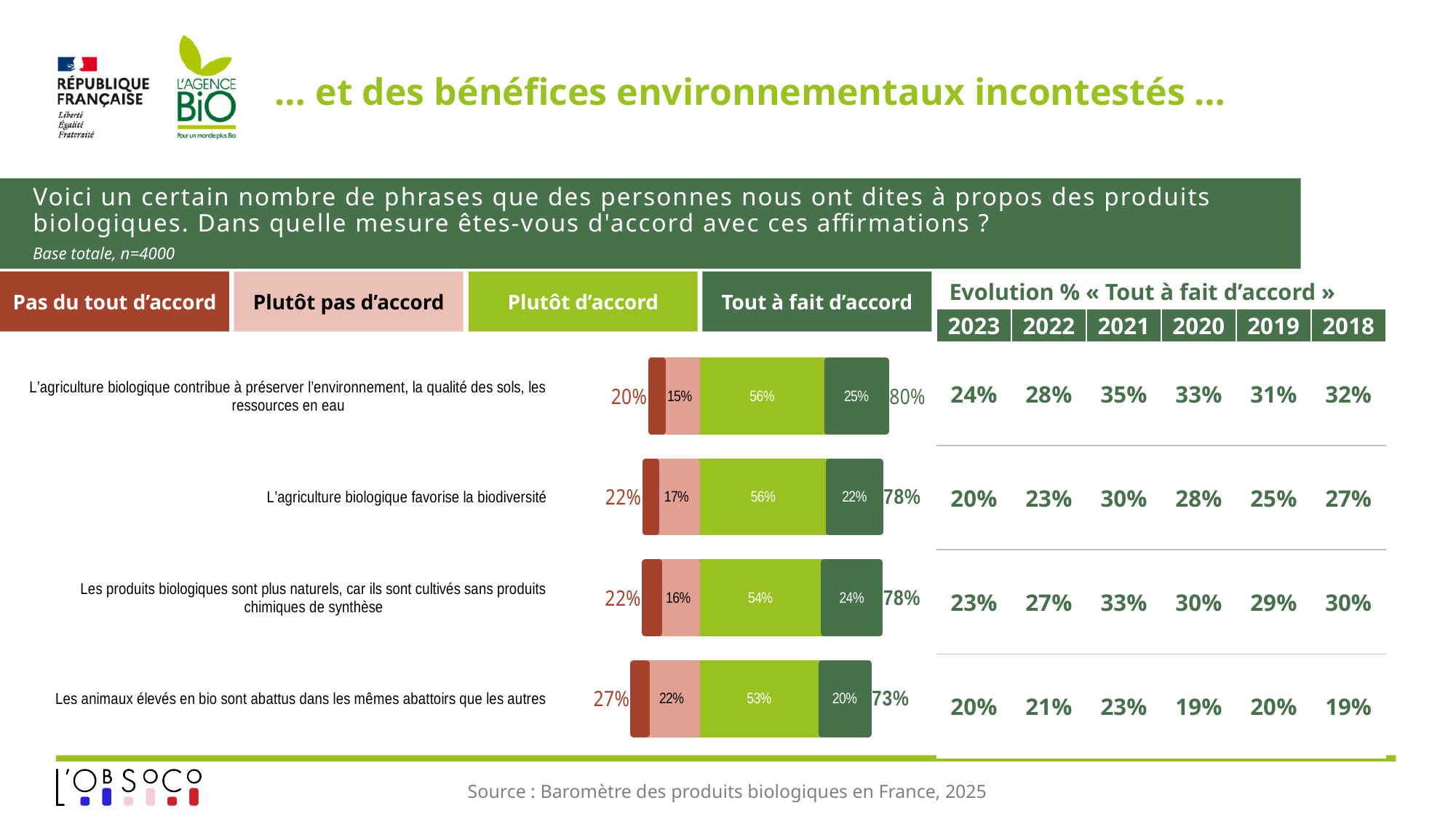
Which statement has the highest combined agreement total (Plutôt d'accord + Tout à fait d'accord)? L'agriculture biologique contribue à préserver l'environnement, la qualité des sols, les ressources en eau What is the 'Plutôt d'accord' value for the statement 'Les produits biologiques sont plus naturels, car ils sont cultivés sans produits chimiques de synthèse'? 54% What is the difference between the 'Tout à fait d'accord' values for 'L'agriculture biologique contribue à préserver l'environnement...' and 'Les animaux élevés en bio sont abattus dans les mêmes abattoirs que les autres'? 5% How many response categories does the legend list for the bar chart? 4 What is the 'Tout à fait d'accord' value for the statement 'L'agriculture biologique contribue à préserver l'environnement, la qualité des sols, les ressources en eau'? 25% In the 'Evolution % « Tout à fait d'accord »' table, what was the 2021 value for 'L'agriculture biologique favorise la biodiversité'? 30% What kind of chart is used to show the levels of agreement with the statements? Stacked bar chart What is the 'Plutôt pas d'accord' value for the statement 'Les animaux élevés en bio sont abattus dans les mêmes abattoirs que les autres'? 22% Which statement has the lowest 'Tout à fait d'accord' value? Les animaux élevés en bio sont abattus dans les mêmes abattoirs que les autres What is the combined disagreement total shown for the statement 'Les animaux élevés en bio sont abattus dans les mêmes abattoirs que les autres'? 27% How many statements are plotted in the bar chart? 4 Which is larger: the 'Plutôt pas d'accord' value for 'L'agriculture biologique favorise la biodiversité' or for 'Les produits biologiques sont plus naturels...'? L'agriculture biologique favorise la biodiversité